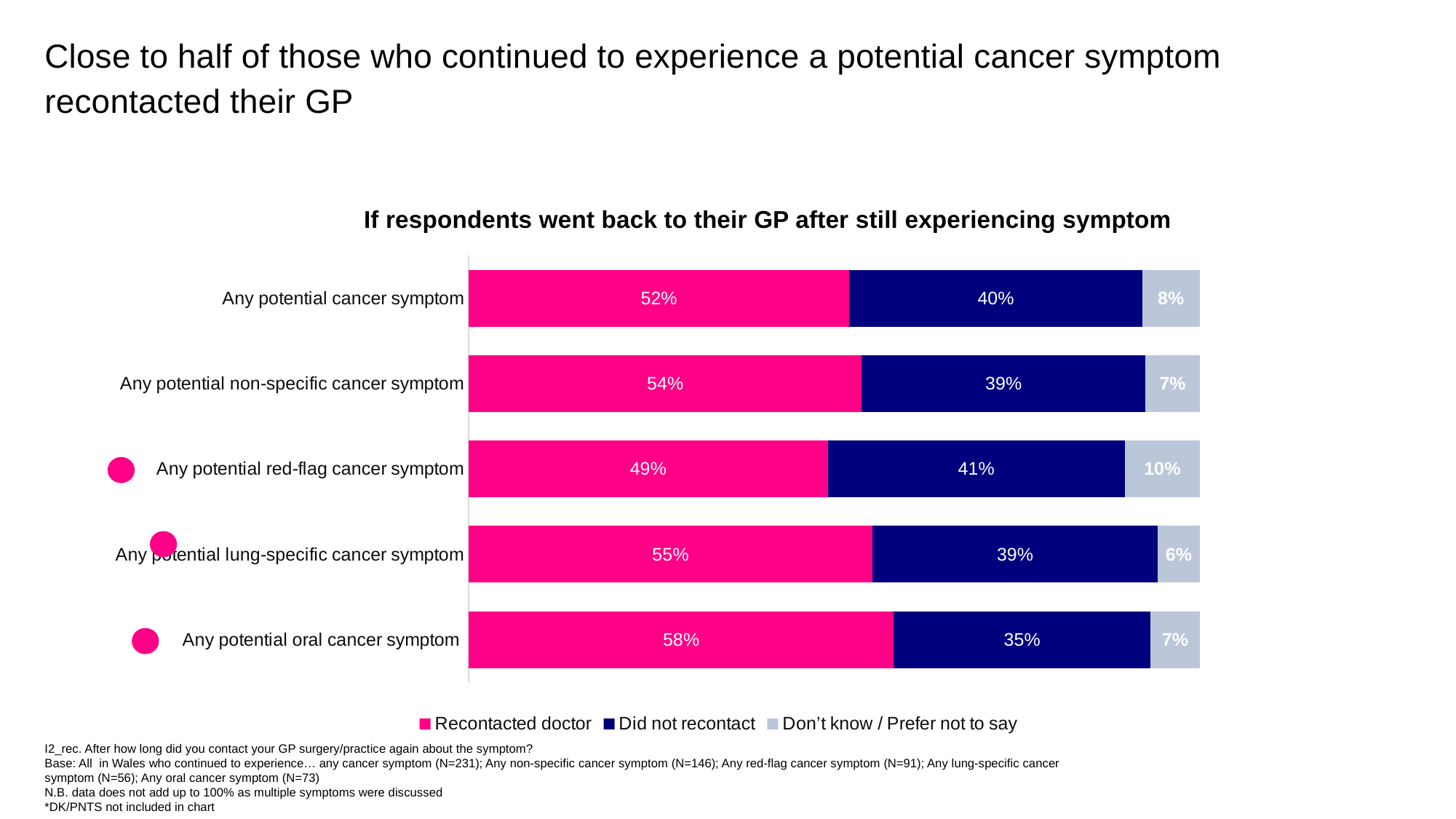
What is the 'Don't know / Prefer not to say' value for any potential red-flag cancer symptom? 10% What is the total of the stacked bar for any potential lung-specific cancer symptom? 100% What percentage of respondents with any potential cancer symptom recontacted their doctor? 52% What is the title of the chart? If respondents went back to their GP after still experiencing symptom Which category has the lowest percentage of respondents who recontacted their doctor? Any potential red-flag cancer symptom Which is larger: the 'Did not recontact' value for any potential red-flag cancer symptom or for any potential oral cancer symptom? Any potential red-flag cancer symptom How many series does the legend list? 3 What percentage of respondents with any potential oral cancer symptom did not recontact their GP? 35% Which category has the highest percentage of respondents who recontacted their doctor? Any potential oral cancer symptom How many categories are shown on the chart? 5 What kind of chart is shown on the slide? Stacked bar chart What is the difference between the 'Recontacted doctor' percentages for any potential oral cancer symptom and any potential red-flag cancer symptom? 9%